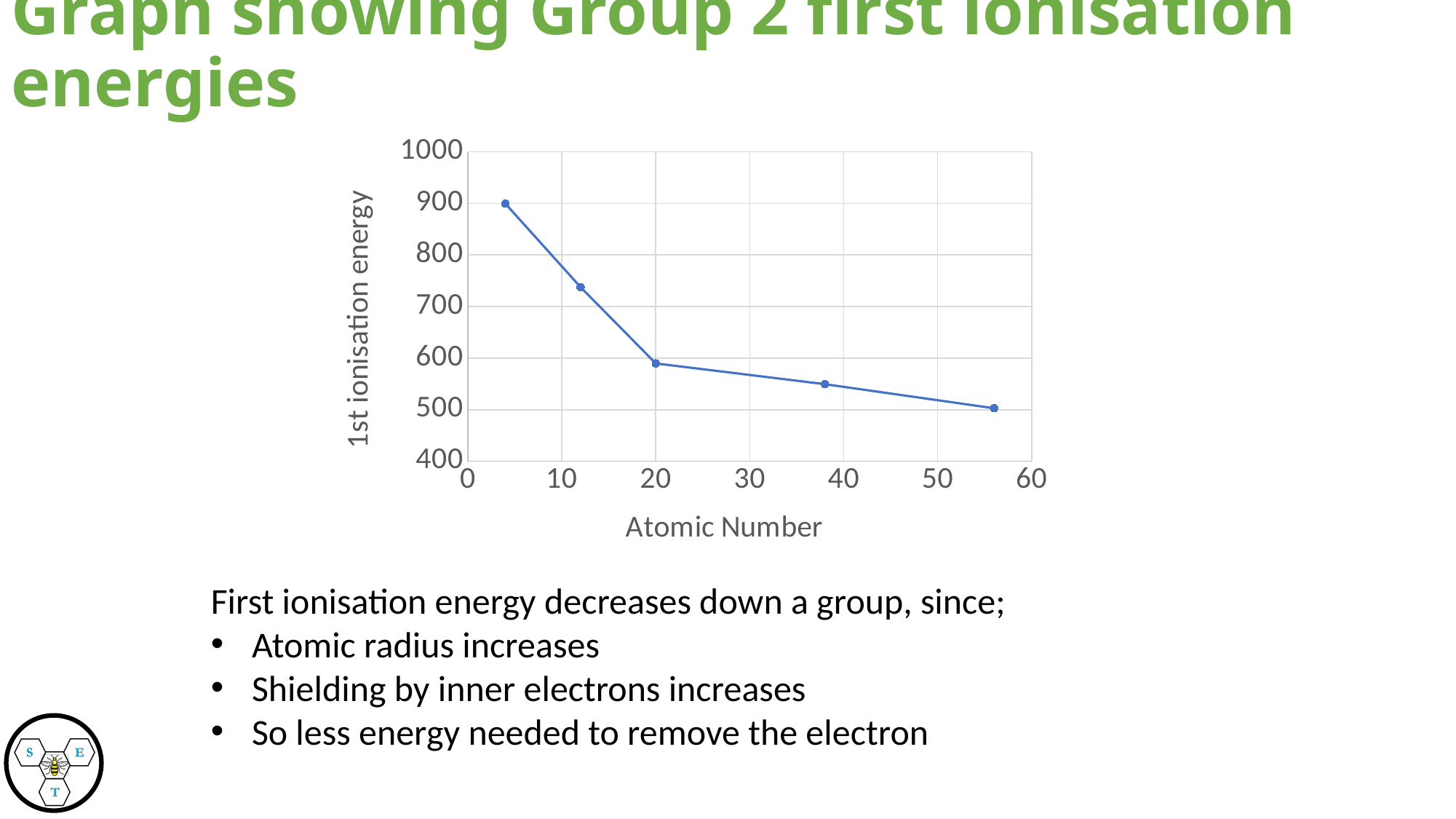
Is the first ionisation energy of the first plotted point (lowest atomic number) greater or less than 800? greater Does the first ionisation energy rise or fall as atomic number increases along the x axis? fall What kind of chart is shown on the slide? line chart What is the label on the y axis of the chart? 1st ionisation energy Is the first ionisation energy of the last plotted point (highest atomic number) greater or less than 600? less Which plotted point has the lowest first ionisation energy? the point with the highest atomic number (the last point) What is the label on the x axis of the chart? Atomic Number How many data points are plotted on the chart? 5 Is the first ionisation energy of the second plotted point (atomic number just above 10) greater or less than 700? greater Which plotted point has the highest first ionisation energy? the point with the lowest atomic number (the first point) Which has the larger first ionisation energy: the second plotted point or the third plotted point? the second plotted point